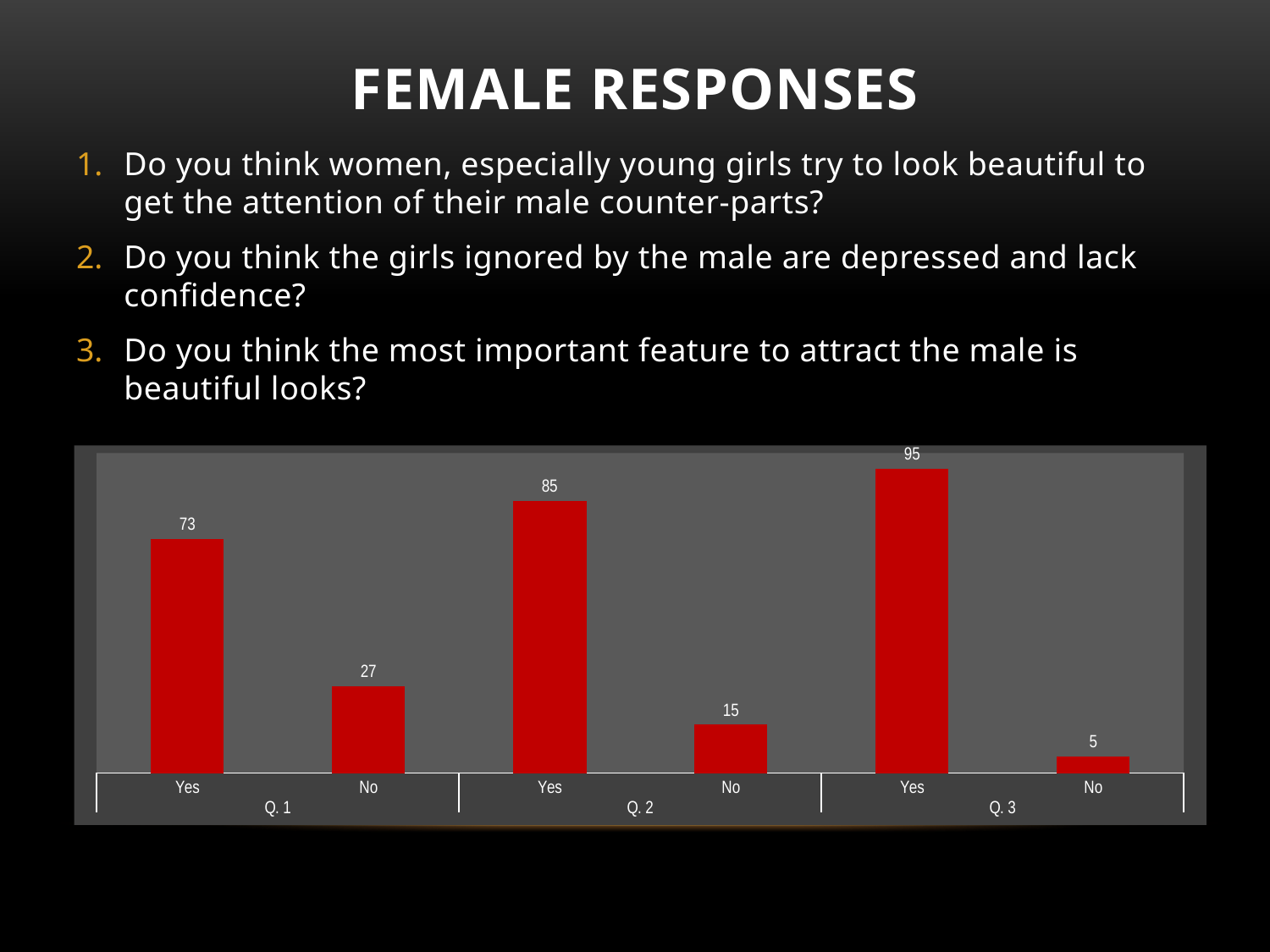
How many bars are plotted in the chart? 6 What is the difference between Yes and No under Q. 1? 46 What is the value for No under Q. 2? 15 Which bar has the lowest value? No under Q. 3 Which bar has the highest value? Yes under Q. 3 What is the value for Yes under Q. 1? 73 What kind of chart is shown on the slide? Bar chart What colour are the bars in the chart? Red Which is larger, the No value for Q. 1 or the No value for Q. 2? No for Q. 1 What is the difference between the Yes values for Q. 3 and Q. 2? 10 What is the value for Yes under Q. 3? 95 How many question groups are shown on the x axis? 3